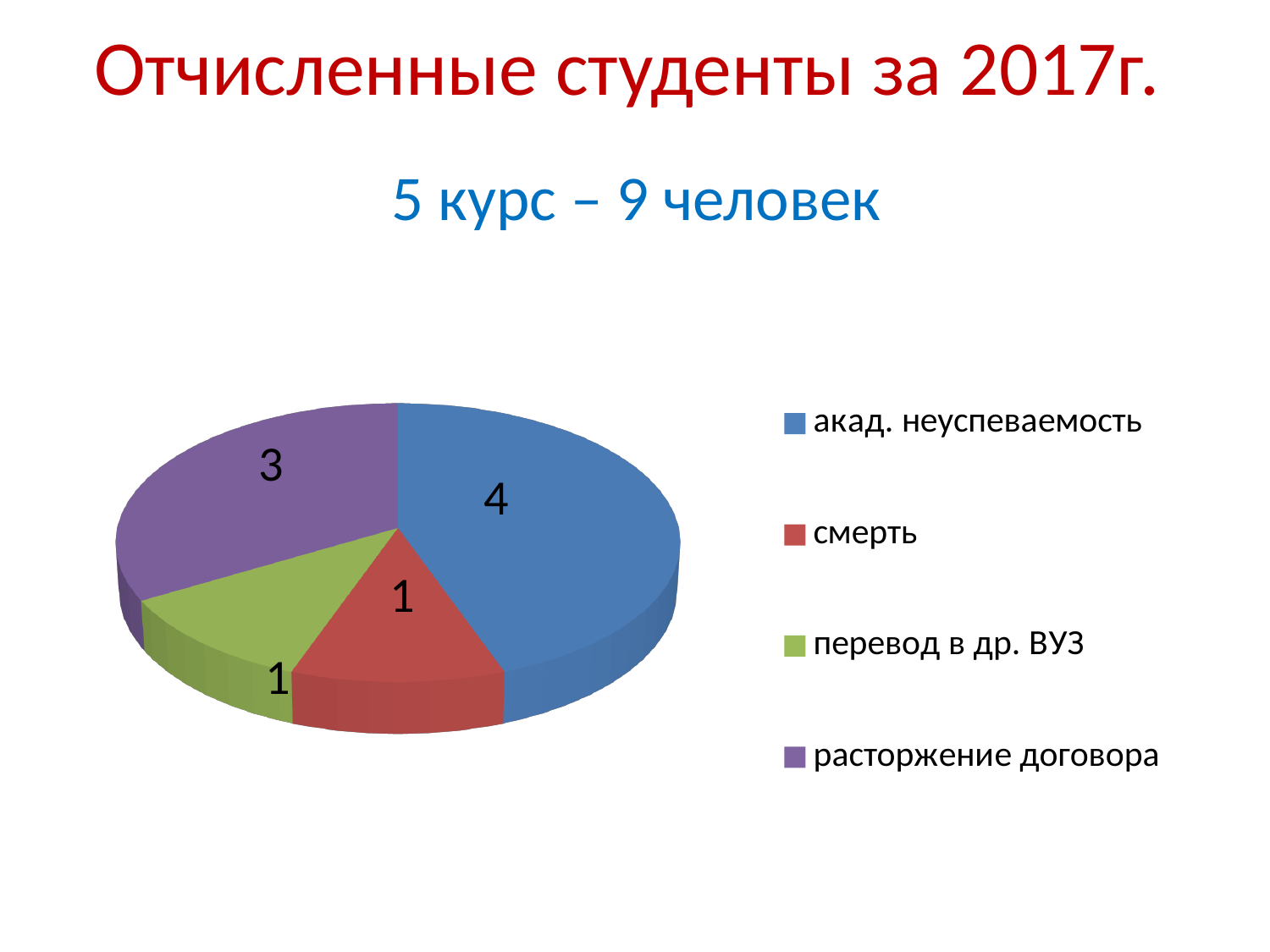
What is the value for перевод в др. ВУЗ? 1 How many entries does the legend list? 4 Which category has the largest slice? акад. неуспеваемость What is the value for акад. неуспеваемость? 4 What colour is the slice for перевод в др. ВУЗ? green What is the value for расторжение договора? 3 What is the difference between акад. неуспеваемость and расторжение договора? 1 What is the total of all slices in the pie chart? 9 How many slices does the pie chart have? 4 What kind of chart is shown on the slide? pie chart Which is larger, расторжение договора or смерть? расторжение договора What is the value for смерть? 1